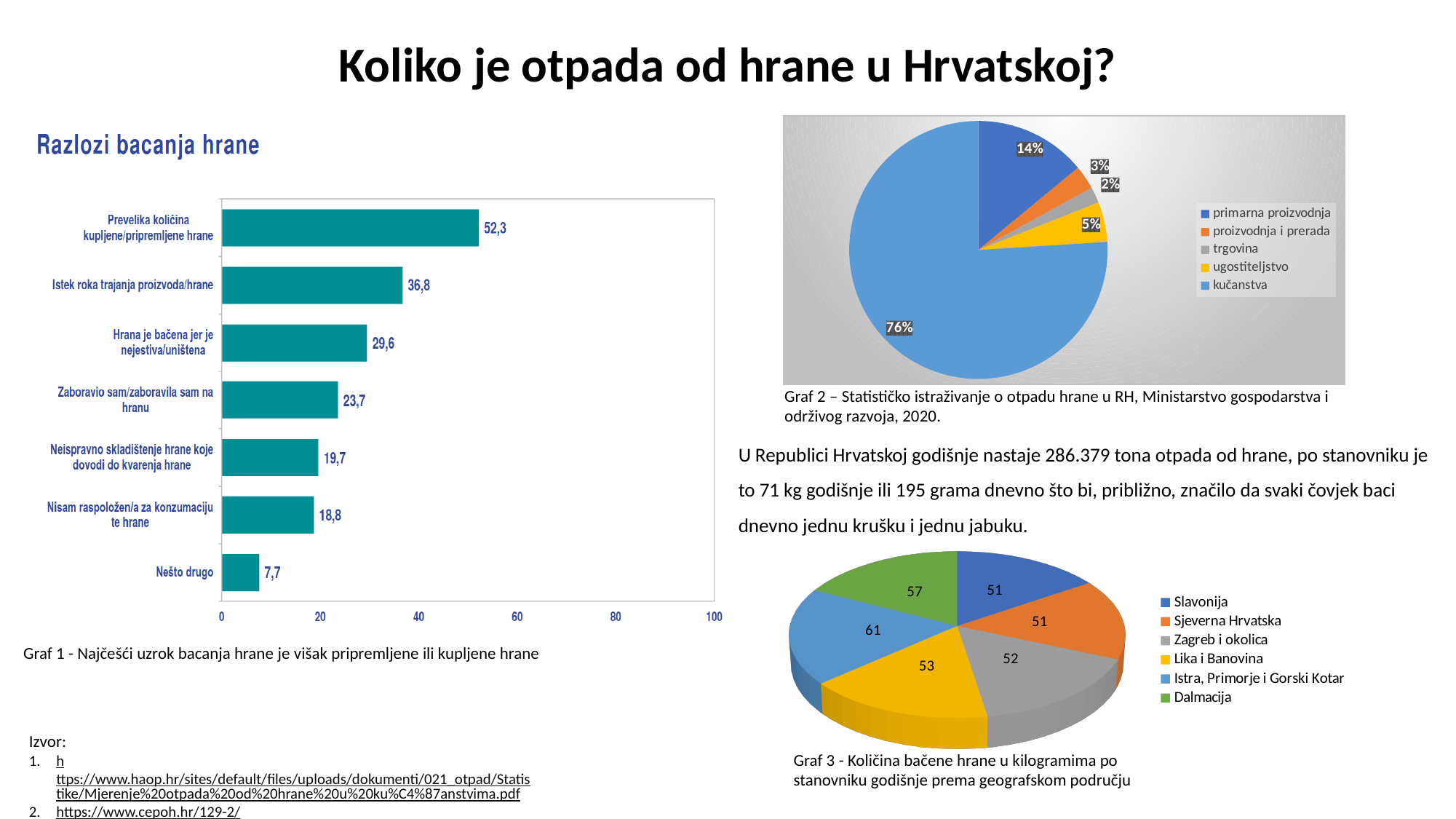
In the bar chart 'Razlozi bacanja hrane', which category has the lowest value? Nešto drugo In the bar chart 'Razlozi bacanja hrane', how many categories are shown? 7 In the pie chart Graf 2 (top right), what share does 'kučanstva' have? 76% In the bar chart 'Razlozi bacanja hrane', what is the value for 'Istek roka trajanja proizvoda/hrane'? 36,8 In the bar chart 'Razlozi bacanja hrane', which category has the highest value? Prevelika količina kupljene/pripremljene hrane In the pie chart Graf 2 (top right), what is the value for 'primarna proizvodnja'? 14% In the bar chart 'Razlozi bacanja hrane', what is the difference between 'Prevelika količina kupljene/pripremljene hrane' and 'Istek roka trajanja proizvoda/hrane'? 15,5 In the pie chart Graf 3 (bottom right), what is the value for 'Dalmacija'? 57 What type of chart is 'Razlozi bacanja hrane'? Bar chart In the pie chart Graf 3 (bottom right), which is larger: 'Lika i Banovina' or 'Istra, Primorje i Gorski Kotar'? Istra, Primorje i Gorski Kotar In the pie chart Graf 2 (top right), how many entries does the legend list? 5 In the pie chart Graf 3 (bottom right), which region has the highest value? Istra, Primorje i Gorski Kotar